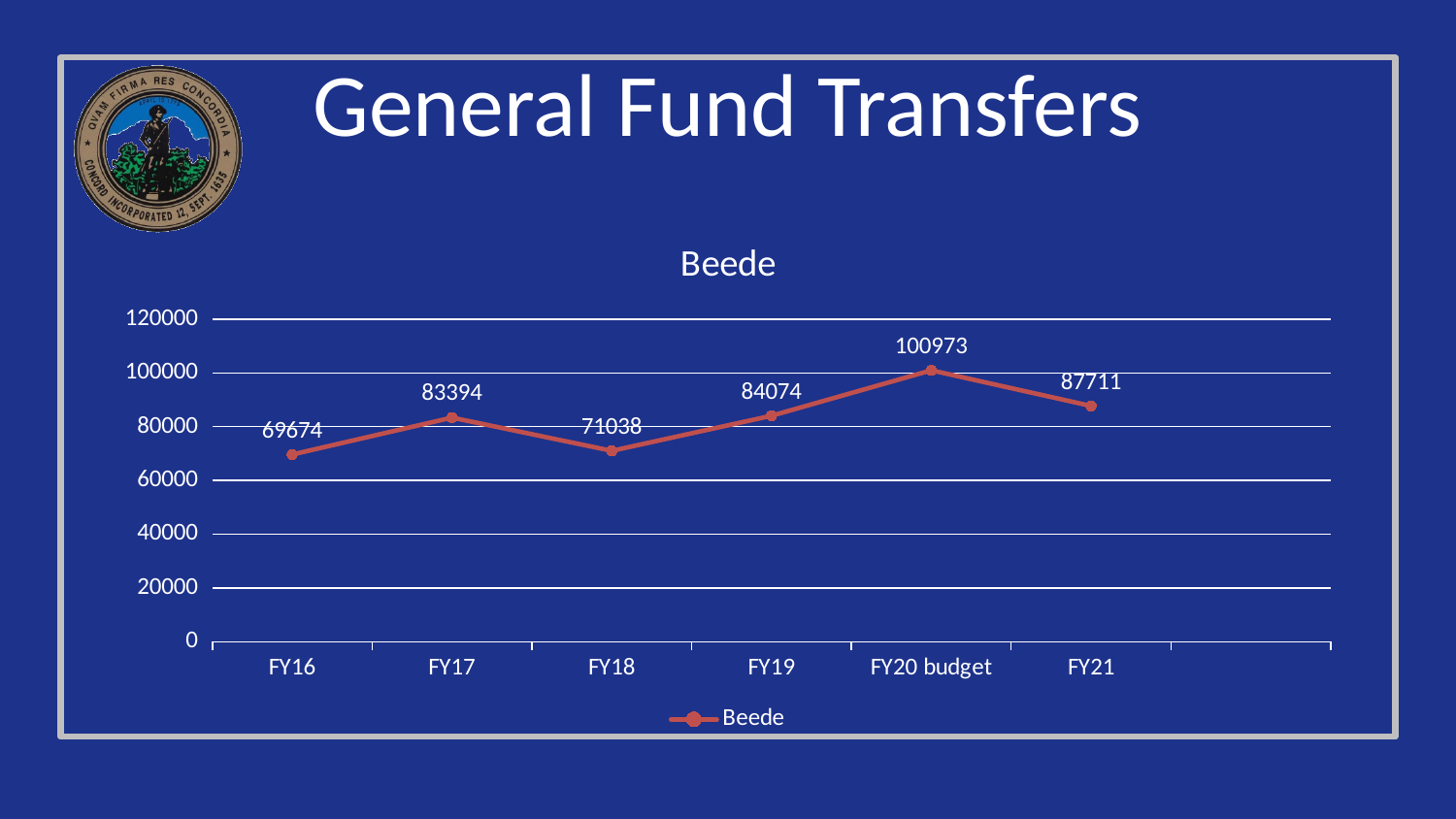
What kind of chart is shown? line chart What is the value for FY21? 87711 How many fiscal years are plotted on the x axis? 6 What is the difference between the FY20 budget value and the FY21 value? 13262 Is the value for FY19 greater or less than 80000? greater What is the title of the chart? Beede Which fiscal year has the highest value? FY20 budget What is the value for FY20 budget? 100973 What is the value for FY16? 69674 Which fiscal year has the lowest value? FY16 Which is larger, the value for FY17 or the value for FY18? FY17 How many series does the legend list? 1